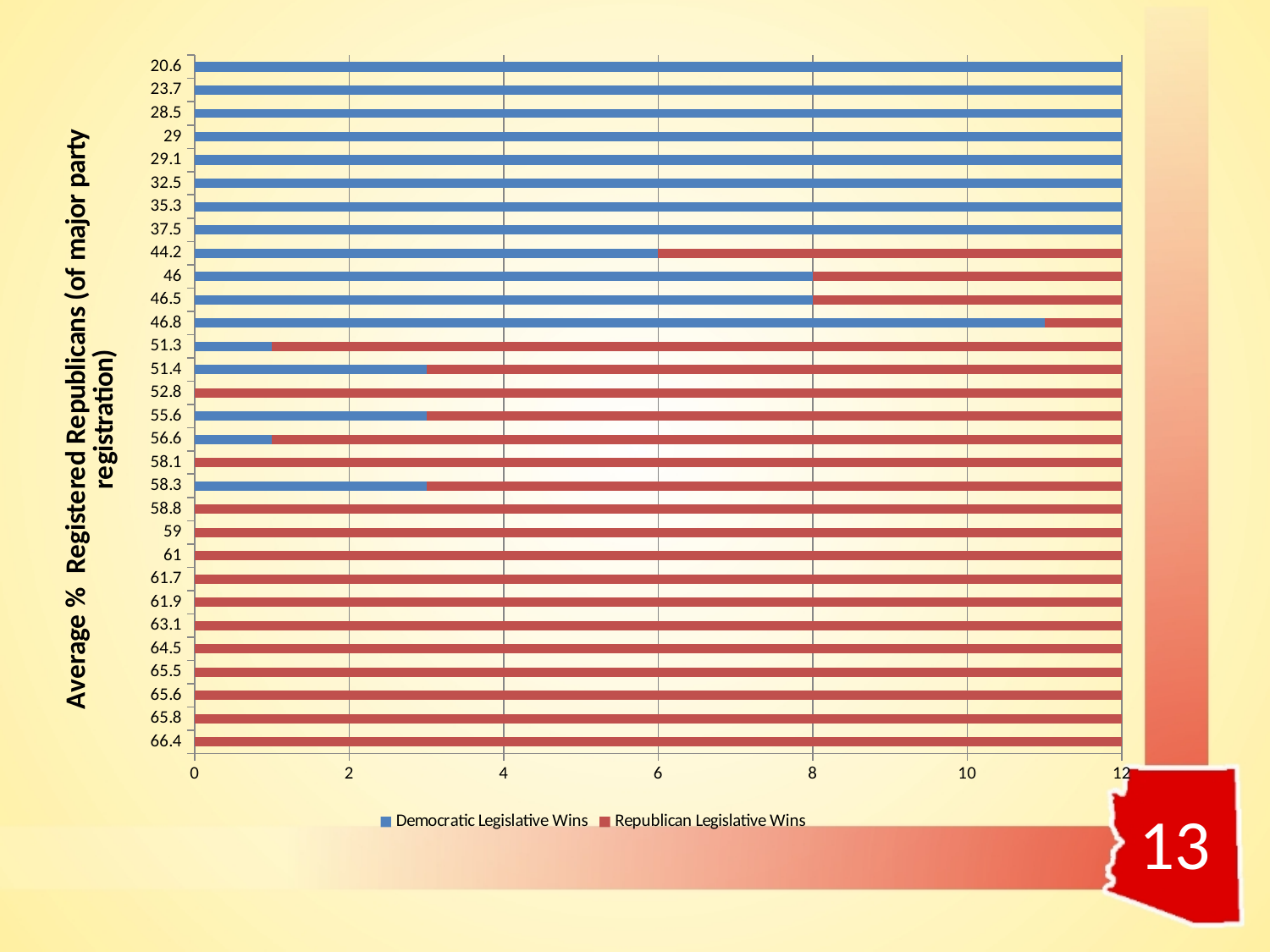
Is the value of Democratic Legislative Wins for the 51.4 category greater or less than 4? less What kind of chart is shown on the slide? bar chart What is the total of the stacked bar for the 20.6 category? 12 How many categories (registration percentages) are plotted on the y axis? 30 What is the value of Democratic Legislative Wins for the 46 category? 8 What is the value of Democratic Legislative Wins for the 44.2 category? 6 As the average % of registered Republicans increases down the y axis, do Democratic Legislative Wins generally rise or fall? fall Is the value of Democratic Legislative Wins for the 46.8 category greater or less than 10? greater What are the two series named in the legend? Democratic Legislative Wins and Republican Legislative Wins Which category has the larger Democratic Legislative Wins value, 46.8 or 51.3? 46.8 How many series does the legend list? 2 What is the value of Democratic Legislative Wins for the 66.4 category? 0